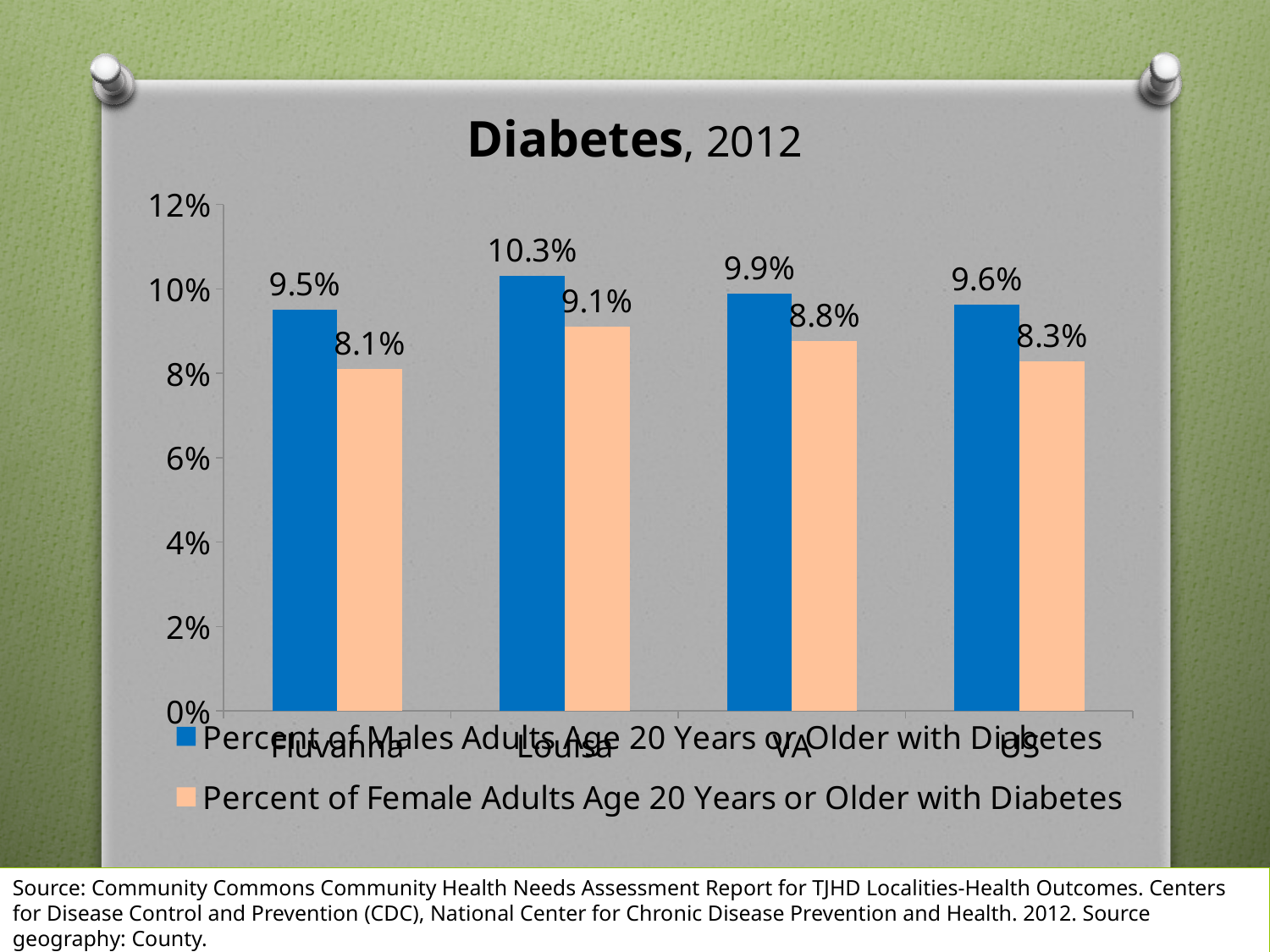
Is the percent of female adults with diabetes in Louisa greater or less than 10%? less What kind of chart is shown on the slide? bar chart How many localities are shown on the x axis? 4 What is the percent of female adults age 20 years or older with diabetes in Fluvanna? 8.1% Which locality has the highest percent of male adults with diabetes? Louisa Which locality has the lowest percent of female adults with diabetes? Fluvanna Which is larger: the percent of male adults with diabetes in Fluvanna or in the US? US What is the percent of female adults age 20 years or older with diabetes in the US? 8.3% What is the difference between the male and female diabetes percentages in VA? 1.1% What is the title of the chart? Diabetes, 2012 How many series does the legend list? 2 What is the percent of male adults age 20 years or older with diabetes in Louisa? 10.3%